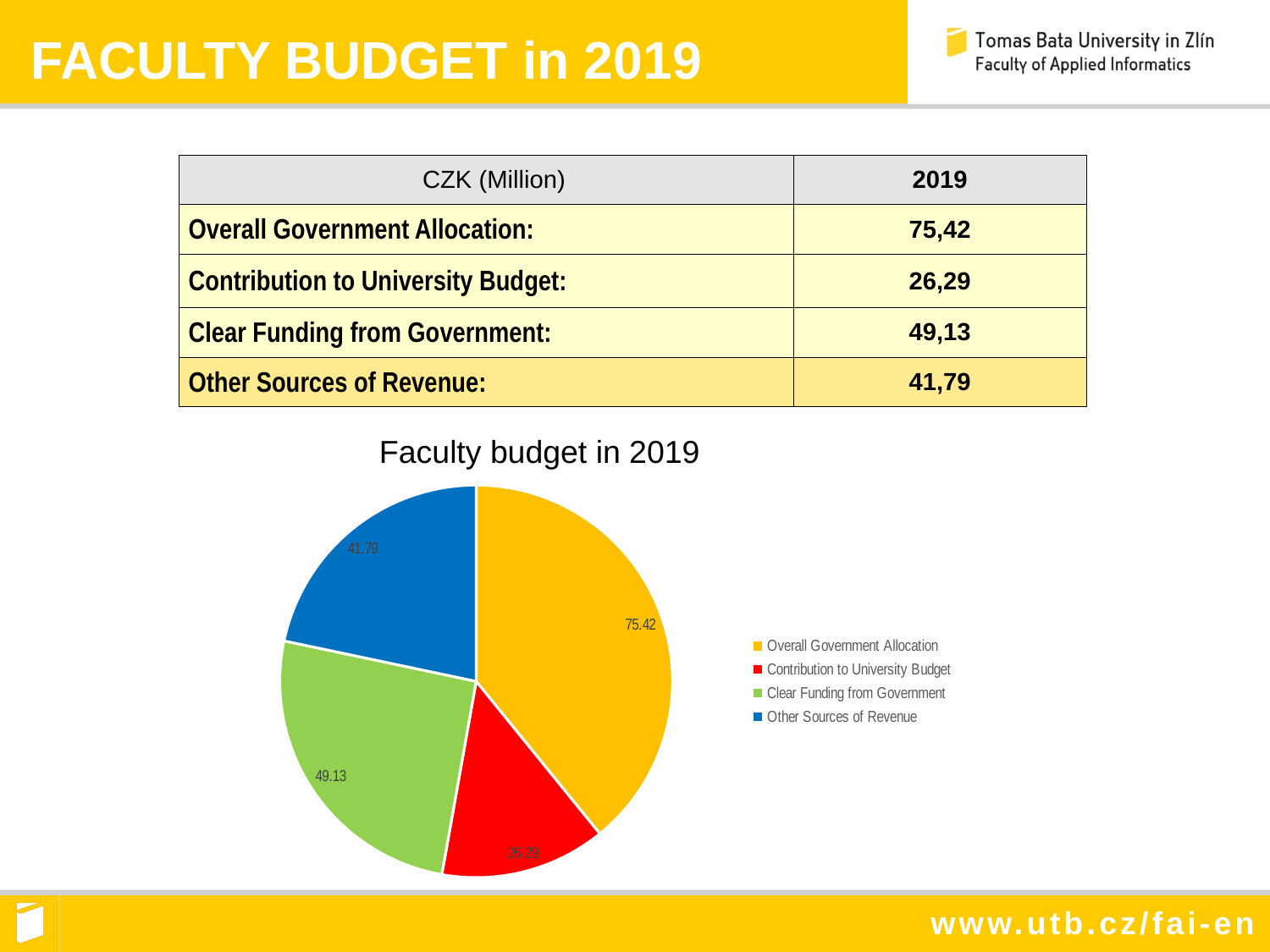
Which colour represents Other Sources of Revenue in the pie chart? blue What is the difference between the Overall Government Allocation value and the Contribution to University Budget value in the pie chart? 49.13 What value is shown for Other Sources of Revenue in the pie chart? 41.79 What is the title of the chart? Faculty budget in 2019 How many slices does the pie chart have? 4 What value is shown for Contribution to University Budget in the pie chart? 26.29 Which category has the largest slice in the pie chart? Overall Government Allocation Which category has the smallest slice in the pie chart? Contribution to University Budget Which is larger in the pie chart: Clear Funding from Government or Other Sources of Revenue? Clear Funding from Government What kind of chart is shown on the slide? pie chart What value is shown for Overall Government Allocation in the pie chart? 75.42 What value is shown for Clear Funding from Government in the pie chart? 49.13